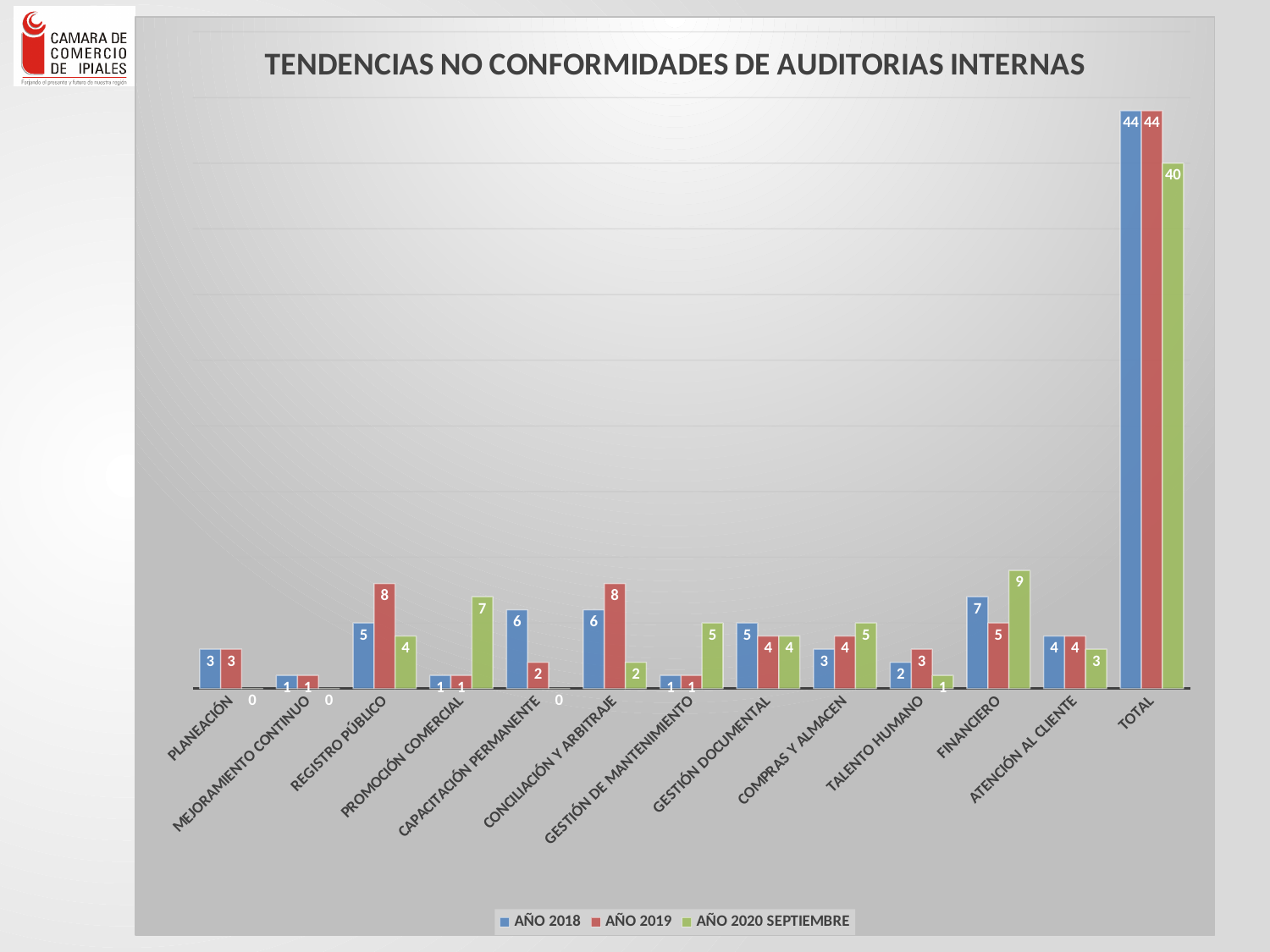
What is the difference between the AÑO 2019 and AÑO 2018 values for REGISTRO PÚBLICO? 3 Excluding TOTAL, which category has the highest value in the AÑO 2018 series? FINANCIERO Excluding TOTAL, which category has the highest value in the AÑO 2020 SEPTIEMBRE series? FINANCIERO What is the TOTAL value for the AÑO 2020 SEPTIEMBRE series? 40 What kind of chart is shown on the slide? Bar chart What is the value for REGISTRO PÚBLICO in the AÑO 2019 series? 8 What is the difference between the TOTAL for AÑO 2018 and the TOTAL for AÑO 2020 SEPTIEMBRE? 4 What is the value for CAPACITACIÓN PERMANENTE in the AÑO 2018 series? 6 How many categories are shown on the x axis, including TOTAL? 13 What is the value for FINANCIERO in the AÑO 2020 SEPTIEMBRE series? 9 For PROMOCIÓN COMERCIAL, which series has the larger value, AÑO 2018 or AÑO 2020 SEPTIEMBRE? AÑO 2020 SEPTIEMBRE How many series does the legend list? 3